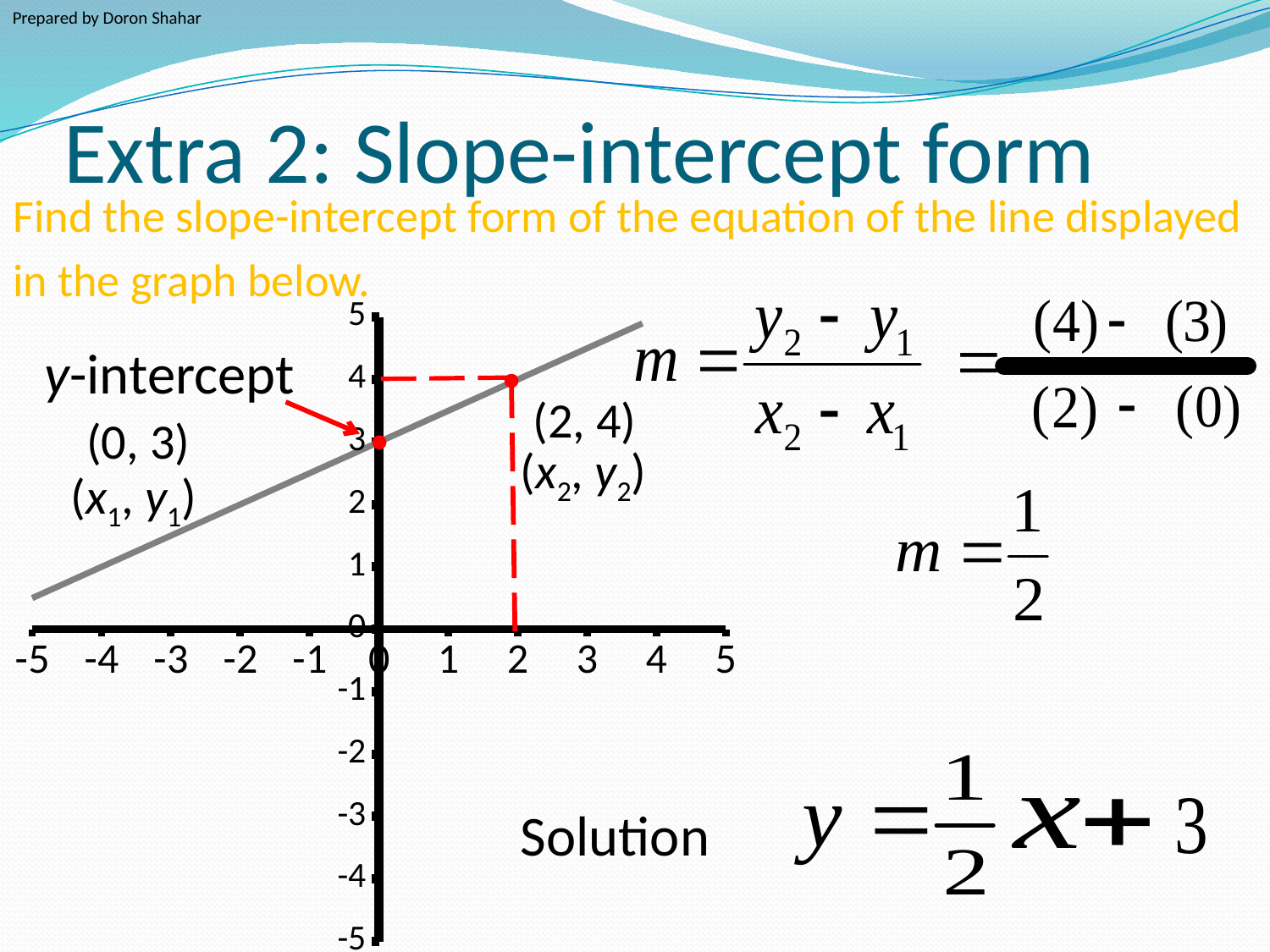
What are the coordinates of the point labelled as the y-intercept? (0, 3) What kind of chart is shown on the slide? line chart What is the highest value shown on the x axis? 5 Is the value of the line at x = -1 greater or less than 3? less Does the line rise or fall as x increases? rises What is the difference between the y-values of the two marked points, (2, 4) and (0, 3)? 1 How many points are marked with red dots on the line? 2 What is the y-value of the marked point on the line at x = 2? 4 What is the y-value of the marked point on the line at x = 0? 3 Is the value of the line at x = 1 greater or less than 3? greater What slope m is given for the line on the slide? 1/2 Which marked point has the larger y-value, (0, 3) or (2, 4)? (2, 4)